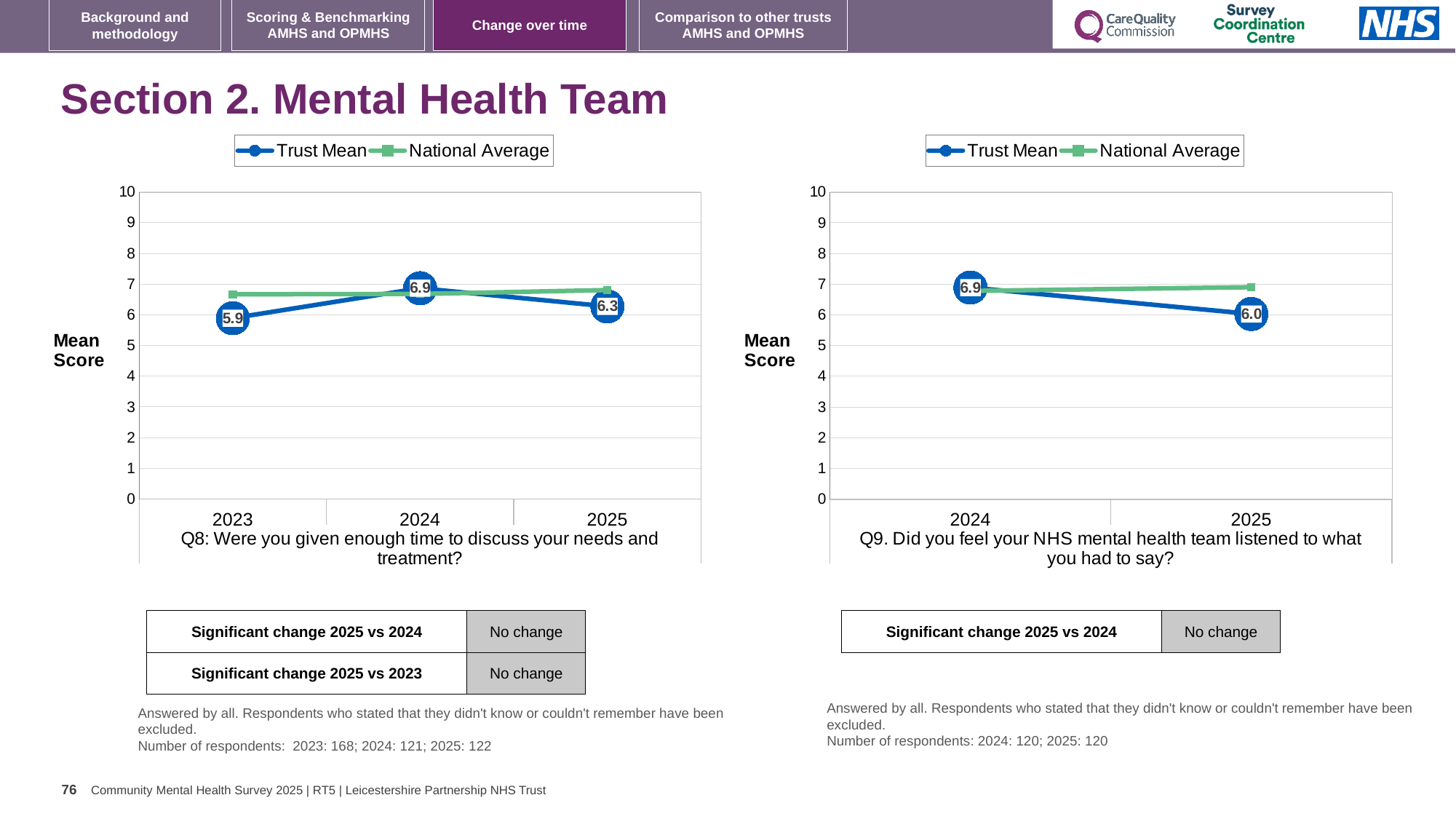
In the Q8 chart on the left, what is the Trust Mean for 2025? 6.3 In the Q9 chart on the right, is the National Average for 2025 greater or less than 6? greater In the Q8 chart on the left, is the Trust Mean for 2024 or 2025 larger? 2024 What kind of chart is the Q8 chart on the left? Line chart In the Q8 chart on the left, which year has the highest Trust Mean? 2024 In the Q9 chart on the right, does the Trust Mean rise or fall from 2024 to 2025? Fall How many years are plotted on the x axis of the Q9 chart on the right? 2 In the Q9 chart on the right, what is the difference between the Trust Mean for 2024 and 2025? 0.9 In the Q9 chart on the right, what is the Trust Mean for 2025? 6.0 In the Q8 chart on the left, which year has the lowest Trust Mean? 2023 How many series does the legend of the Q8 chart on the left list? 2 In the Q8 chart on the left, what is the Trust Mean for 2023? 5.9